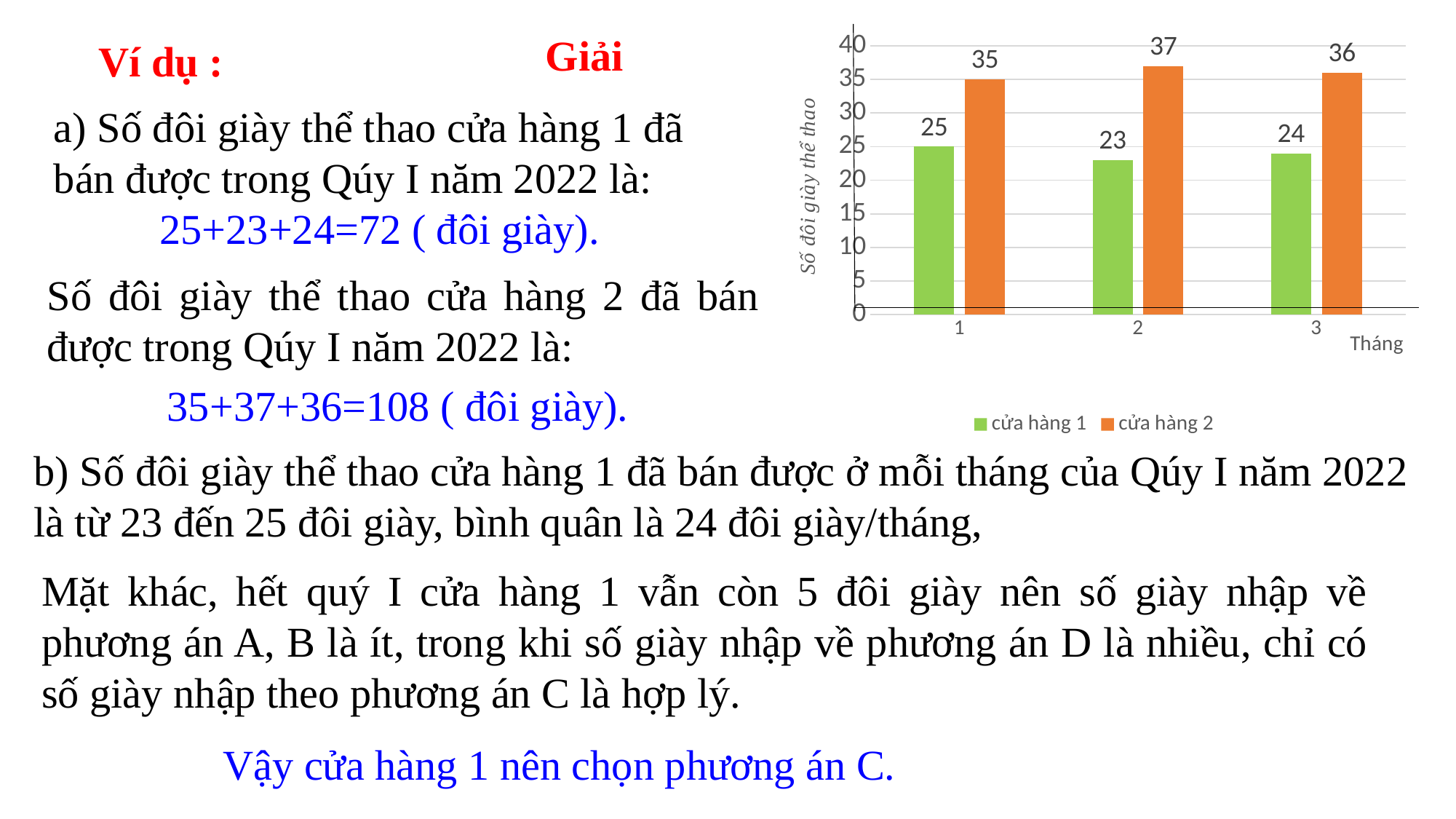
How many series does the legend list? 2 What is the value for cửa hàng 2 in month 2? 37 Is the value for cửa hàng 2 in month 3 greater or less than 30? greater Which is larger in month 3: cửa hàng 1 or cửa hàng 2? cửa hàng 2 In which month is the value for cửa hàng 2 the highest? 2 What is the label of the vertical axis? Số đôi giày thể thao In which month is the value for cửa hàng 1 the lowest? 2 How many months are shown on the x axis? 3 What is the difference between cửa hàng 2 and cửa hàng 1 in month 1? 10 What is the value for cửa hàng 1 in month 1? 25 What kind of chart is shown? bar chart What is the value for cửa hàng 1 in month 3? 24